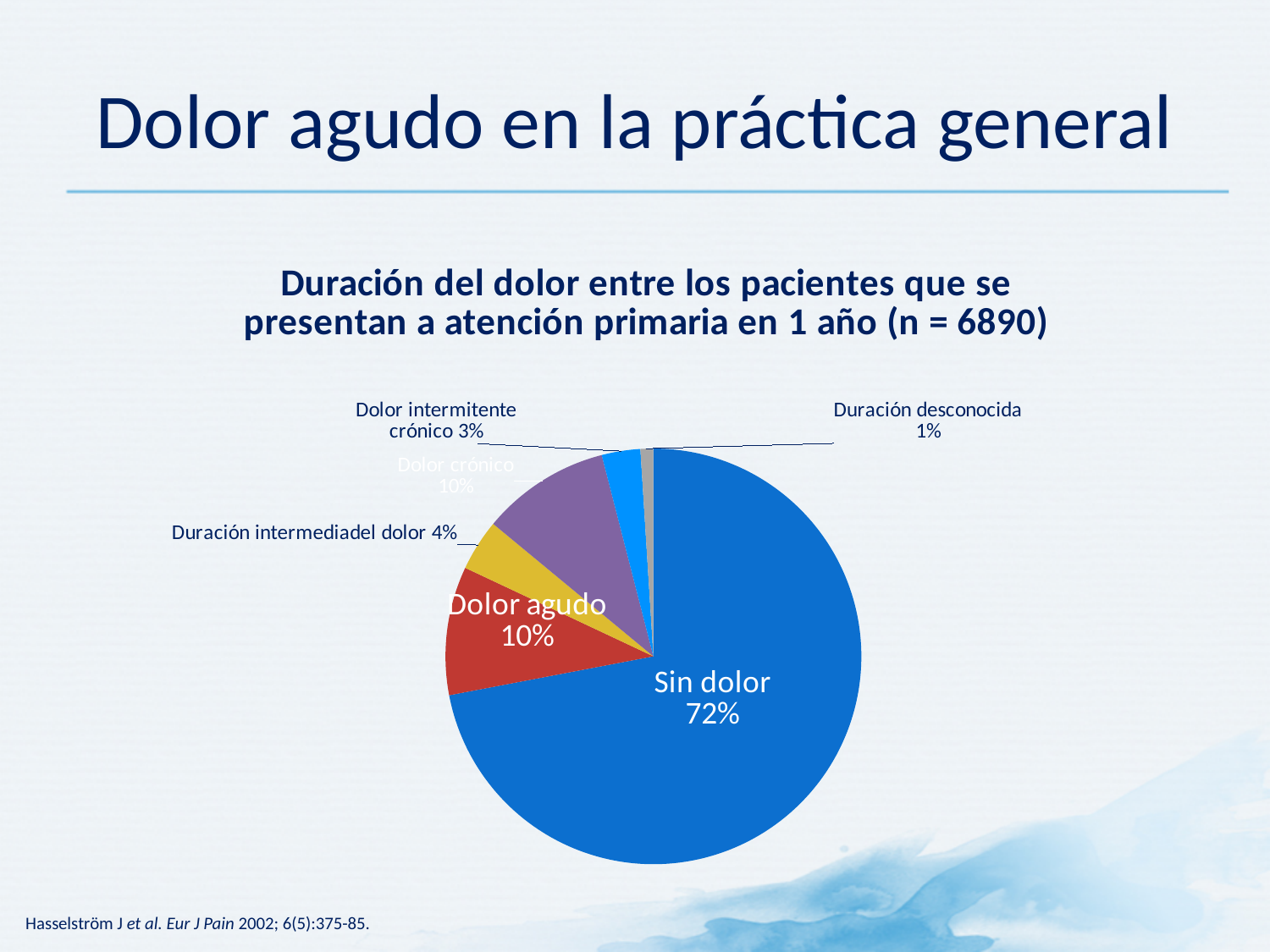
What percentage is shown for "Duración desconocida"? 1% What percentage is shown for "Duración intermedia del dolor"? 4% Which is larger, the slice for "Dolor agudo" or the slice for "Duración intermedia del dolor"? Dolor agudo Which category has the smallest slice of the pie? Duración desconocida What kind of chart is shown on the slide? Pie chart How many slices does the pie chart have? 6 What percentage of patients is shown for "Dolor agudo"? 10% What sample size (n) is given in the chart title? 6890 What is the difference in percentage points between "Sin dolor" and "Dolor agudo"? 62 percentage points What percentage is shown for "Dolor intermitente crónico"? 3% Which category has the largest slice of the pie? Sin dolor What percentage of patients is shown for "Sin dolor"? 72%